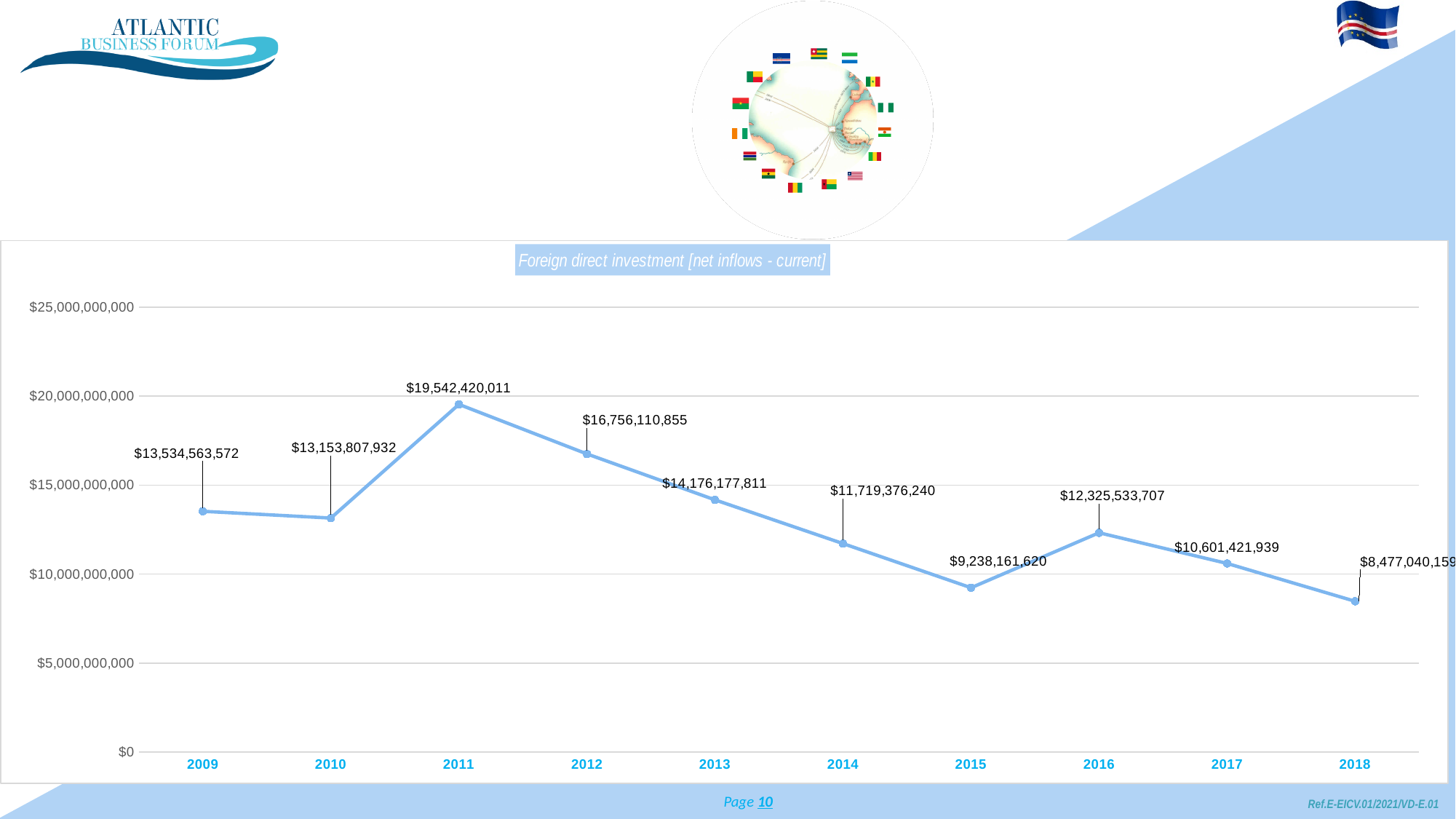
Which year has the lowest foreign direct investment value? 2018 How many years are plotted on the chart? 10 Which year has a larger value, 2016 or 2017? 2016 Which year has the highest foreign direct investment value? 2011 What is the value of foreign direct investment in 2011? $19,542,420,011 What is the value of foreign direct investment in 2015? $9,238,161,620 What type of chart is shown on the slide? Line chart What is the title of the chart? Foreign direct investment [net inflows - current] Is the value for 2012 greater or less than $15,000,000,000? greater What is the difference between the 2011 value and the 2018 value? $11,065,379,852 What is the value of foreign direct investment in 2018? $8,477,040,159 What is the difference between the 2009 value and the 2010 value? $380,755,640